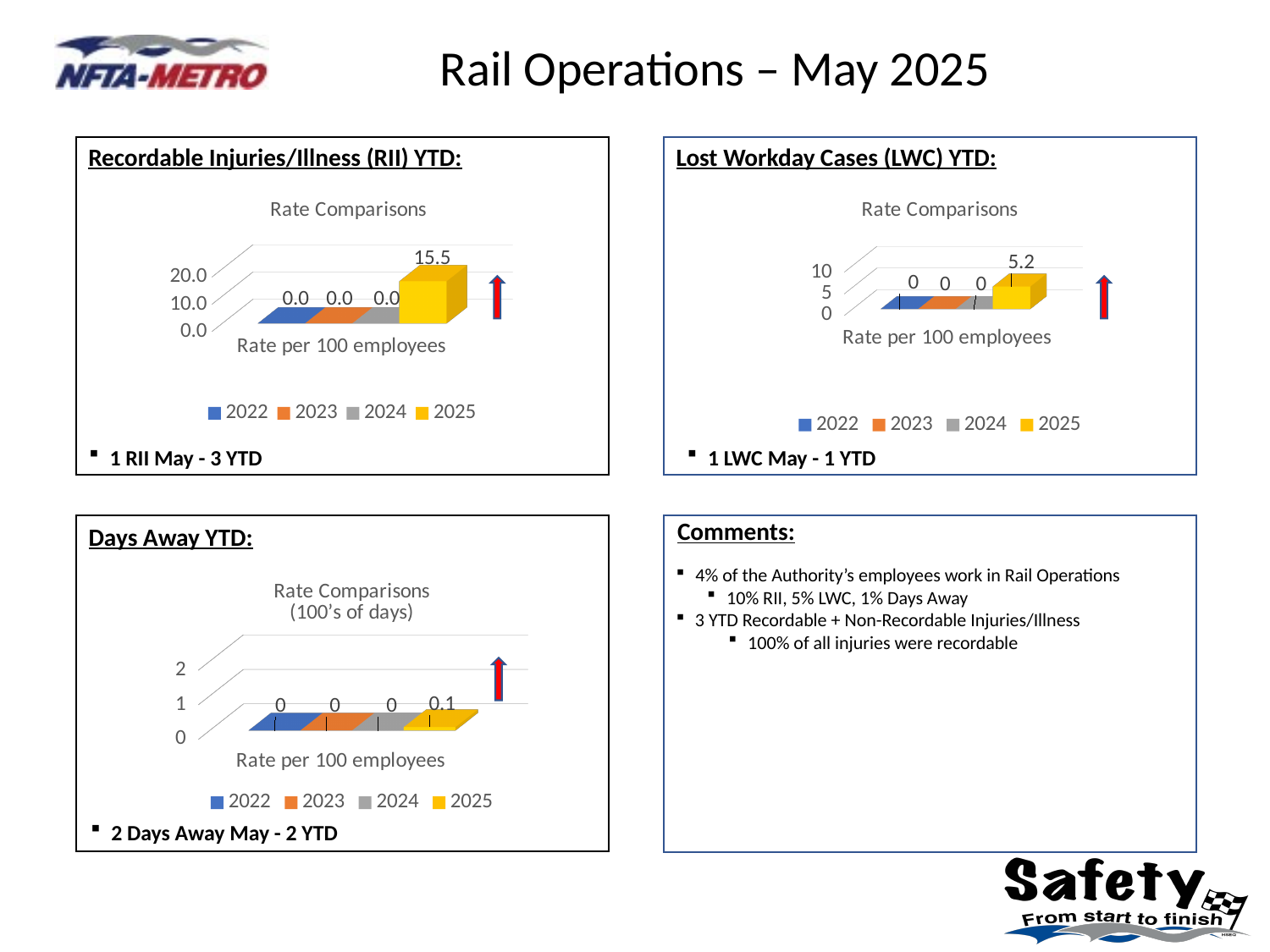
In the Recordable Injuries/Illness (RII) YTD chart, what is the difference between the 2025 value and the 2024 value? 15.5 How many series does the legend of the Days Away YTD chart list? 4 In the Days Away YTD chart, what is the value for 2025? 0.1 What is the title of the chart in the Days Away YTD box? Rate Comparisons (100's of days) In the Lost Workday Cases (LWC) YTD chart, what is the difference between the 2025 value and the 2023 value? 5.2 In the Days Away YTD chart, which is larger, the value for 2025 or the value for 2022? 2025 In the Lost Workday Cases (LWC) YTD chart, which year has the highest value? 2025 In the Lost Workday Cases (LWC) YTD chart, what is the value for 2025? 5.2 In the Recordable Injuries/Illness (RII) YTD chart, is the value for 2025 greater or less than 10.0? greater In the Recordable Injuries/Illness (RII) YTD chart, what is the value for 2024? 0.0 What kind of chart is the Lost Workday Cases (LWC) YTD chart? bar chart In the Recordable Injuries/Illness (RII) YTD chart, what is the value for 2025? 15.5